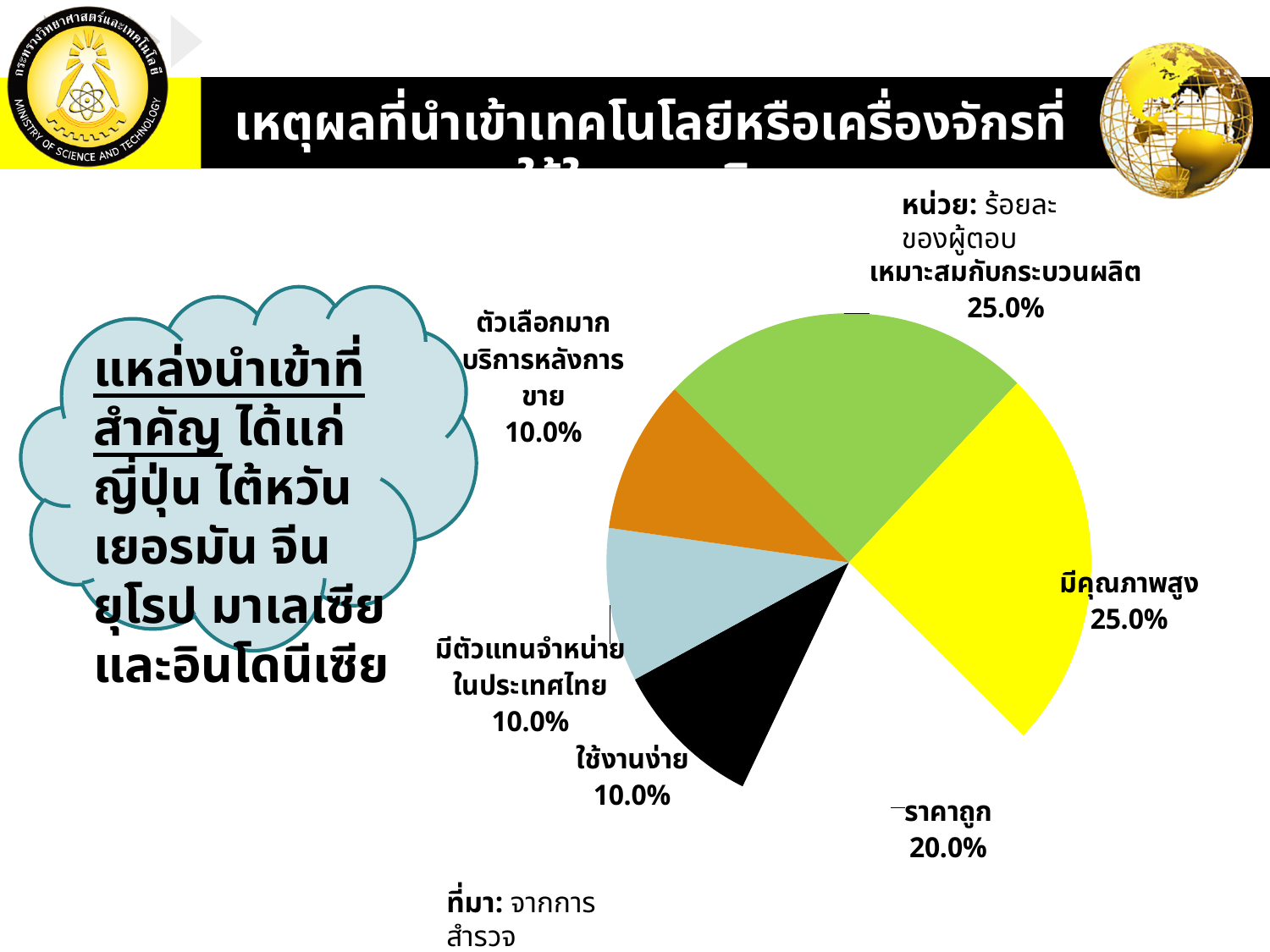
What percentage is shown for มีคุณภาพสูง? 25.0% What percentage is shown for ราคาถูก? 20.0% Which category does the yellow slice represent? มีคุณภาพสูง What percentage is shown for เหมาะสมกับกระบวนผลิต? 25.0% How many slices does the pie chart have? 6 What kind of chart is shown on the slide? pie chart What percentage is shown for มีตัวแทนจำหน่ายในประเทศไทย? 10.0% What unit is stated for the chart values? ร้อยละของผู้ตอบ What is the difference between the share for มีคุณภาพสูง and the share for ราคาถูก? 5.0% What is the difference between the share for เหมาะสมกับกระบวนผลิต and the share for ใช้งานง่าย? 15.0% Which is larger, the share for มีคุณภาพสูง or the share for ราคาถูก? มีคุณภาพสูง What percentage is shown for ใช้งานง่าย? 10.0%